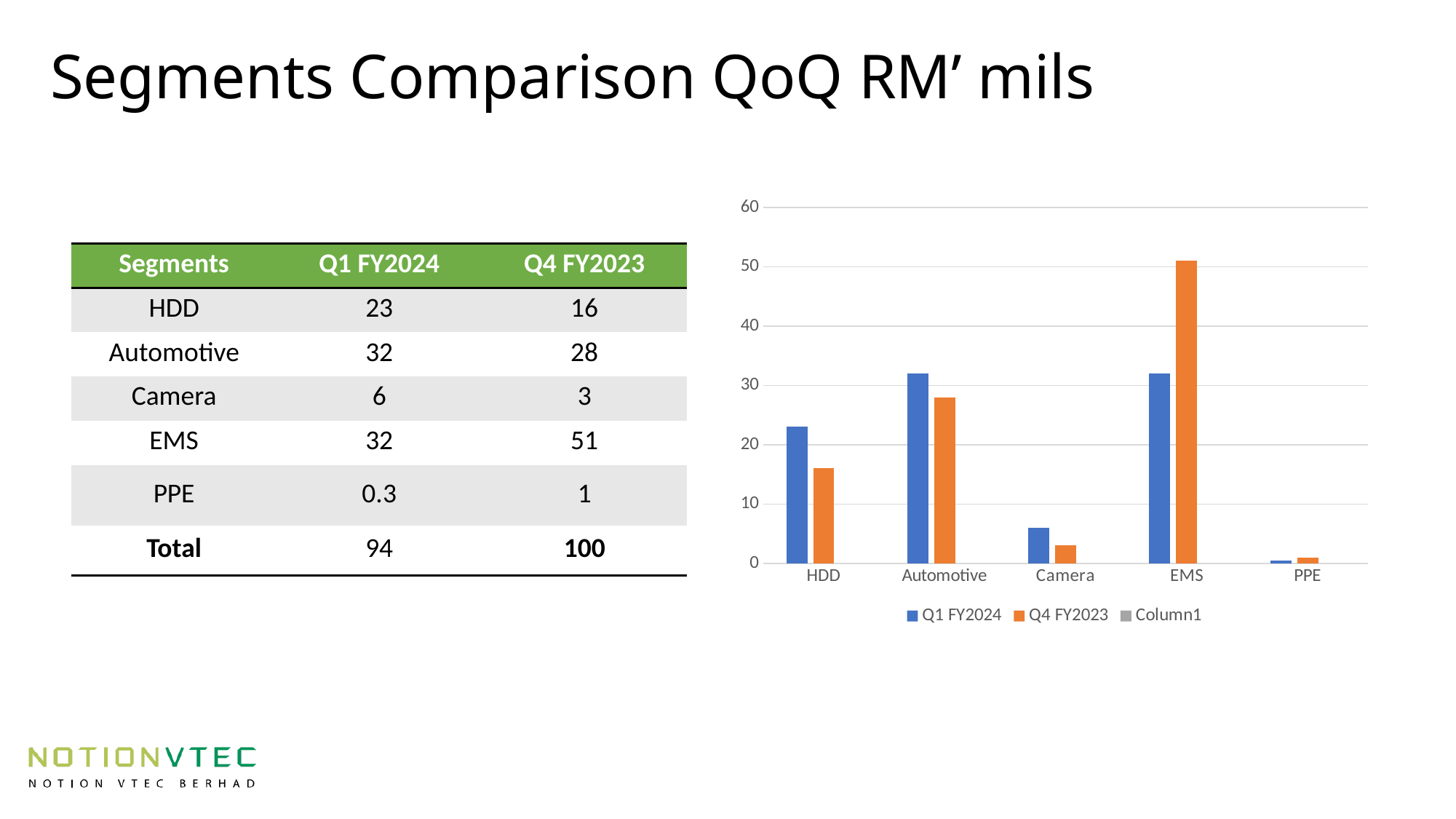
What kind of chart is shown on the slide? bar chart Which segment has the highest Q4 FY2023 value? EMS Which colour represents the Q4 FY2023 series in the chart? orange How many series does the chart legend list? 3 What is the difference between the Q1 FY2024 and Q4 FY2023 values for Automotive? 4 What is the Q4 FY2023 value for EMS? 51 What is the Q1 FY2024 value for HDD? 23 How many segment categories are shown on the x axis of the chart? 5 What is the difference between the Q4 FY2023 and Q1 FY2024 values for EMS? 19 Is the Q4 FY2023 value for EMS greater or less than 40? greater For HDD, which is larger: the Q1 FY2024 value or the Q4 FY2023 value? Q1 FY2024 Which segment has the lowest Q1 FY2024 value? PPE